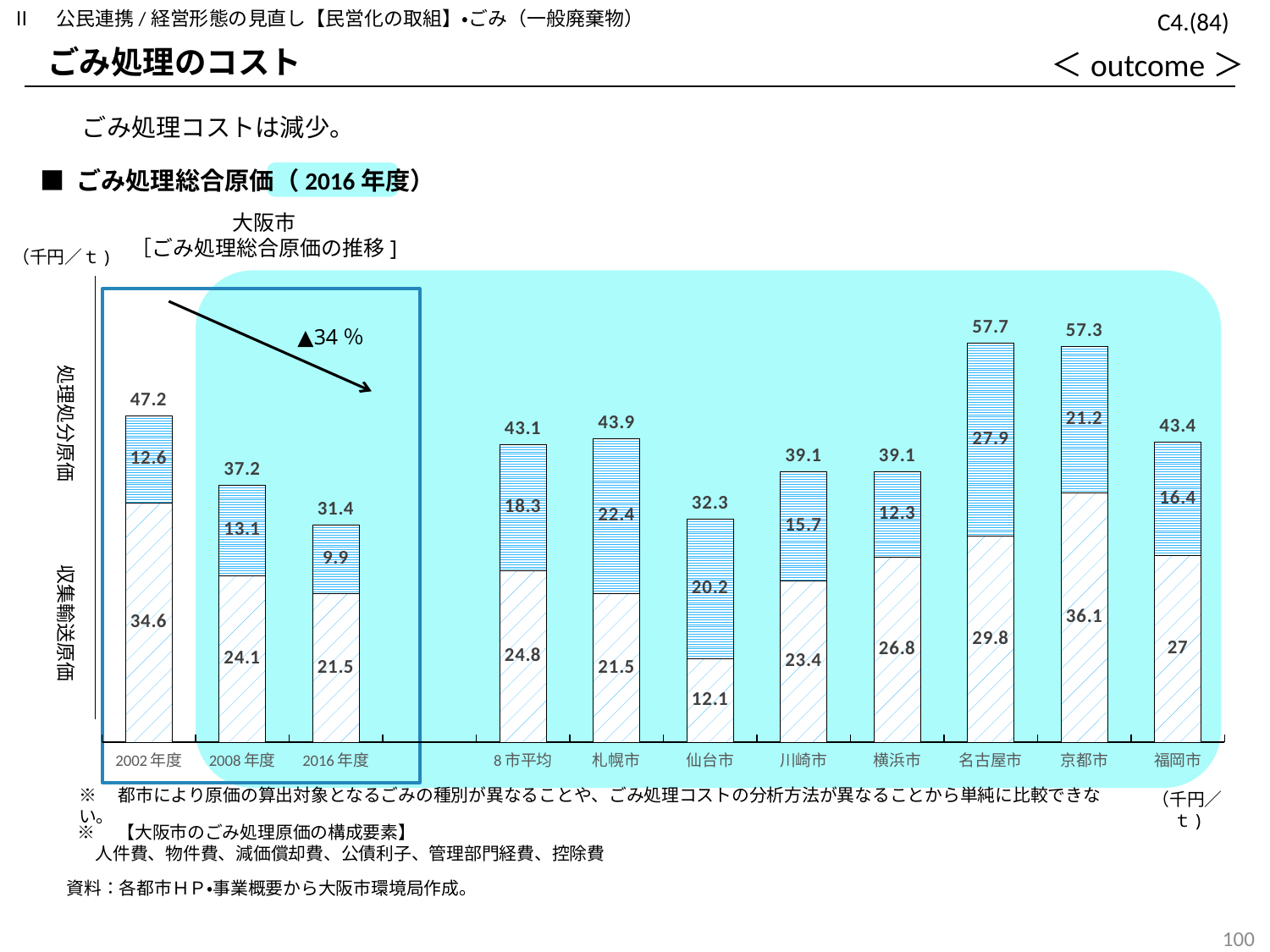
What is the difference between the total for 2002年度 and the total for 2016年度? 15.8 What is the total ごみ処理総合原価 for 大阪市 in 2016年度? 31.4 Do the total values for 大阪市 rise or fall from 2002年度 to 2016年度? Fall What percentage change is indicated by the arrow over the 大阪市 bars? ▲34% What is the 収集輸送原価 value for 2002年度? 34.6 Which has a larger total value, 札幌市 or 福岡市? 札幌市 What is the 収集輸送原価 value for 京都市? 36.1 What type of chart is shown on the slide? Stacked bar chart Which category has the highest total value in the chart? 名古屋市 Which category has the lowest total value in the chart? 2016年度 What is the 処理処分原価 value for 名古屋市? 27.9 How many categories are shown on the x axis of the chart? 11